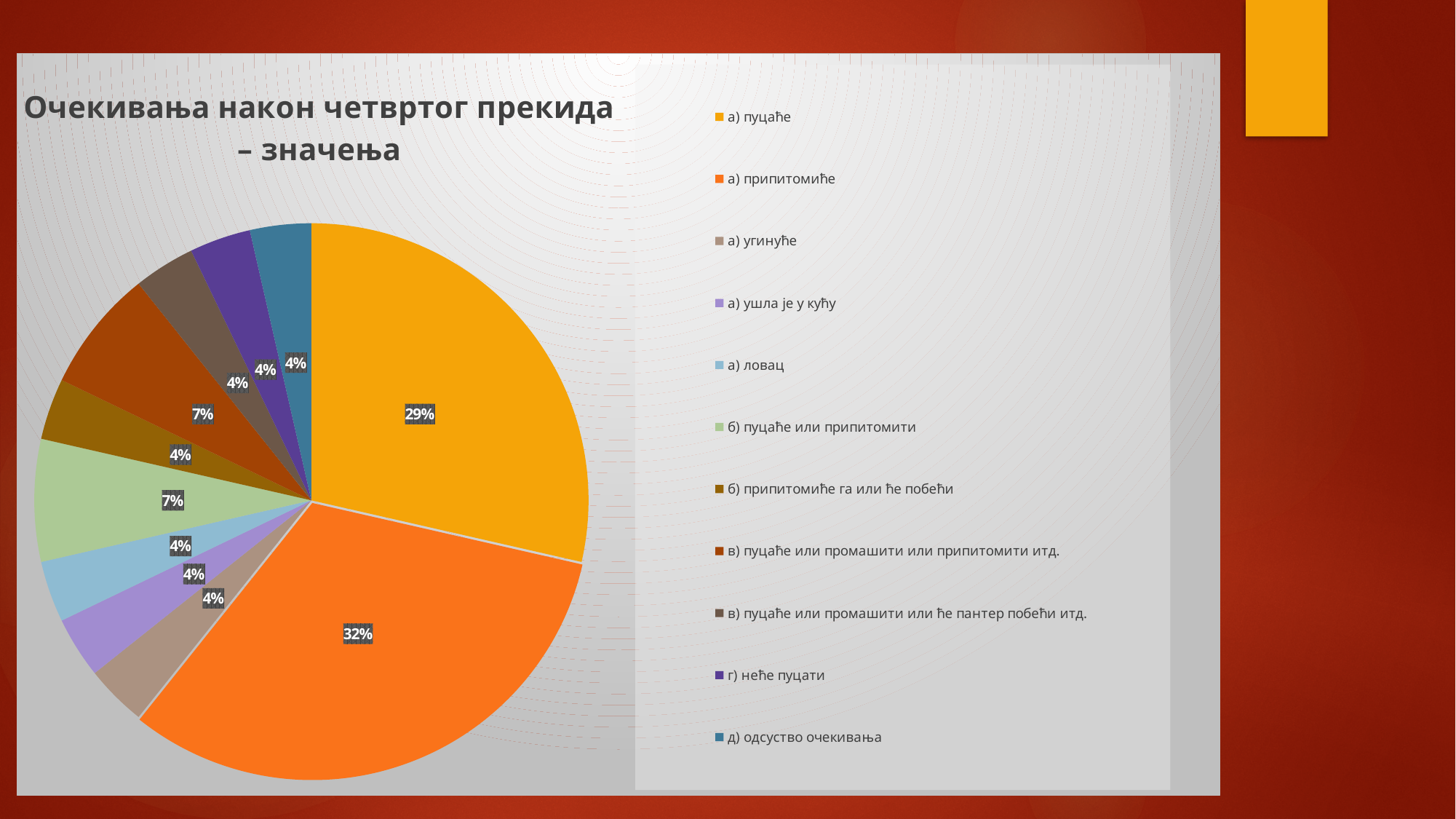
What share of the pie does the slice for "а) пуцаће" represent? 29% How many slices does the pie chart have? 11 Which category has the largest slice of the pie? а) припитомиће What percentage is shown for "д) одсуство очекивања"? 4% What kind of chart is shown on the slide? pie chart What share of the pie does the slice for "а) припитомиће" represent? 32% What percentage is shown for "б) пуцаће или припитомити"? 7% What is the difference in percentage points between the slices for "а) припитомиће" and "а) пуцаће"? 3 What is the combined share of the slices for "а) пуцаће" and "а) припитомиће"? 61% Which slice is larger: "а) пуцаће" or "б) пуцаће или припитомити"? а) пуцаће What percentage is shown for "в) пуцаће или промашити или припитомити итд."? 7% What is the title of the chart? Очекивања након четвртог прекида – значења